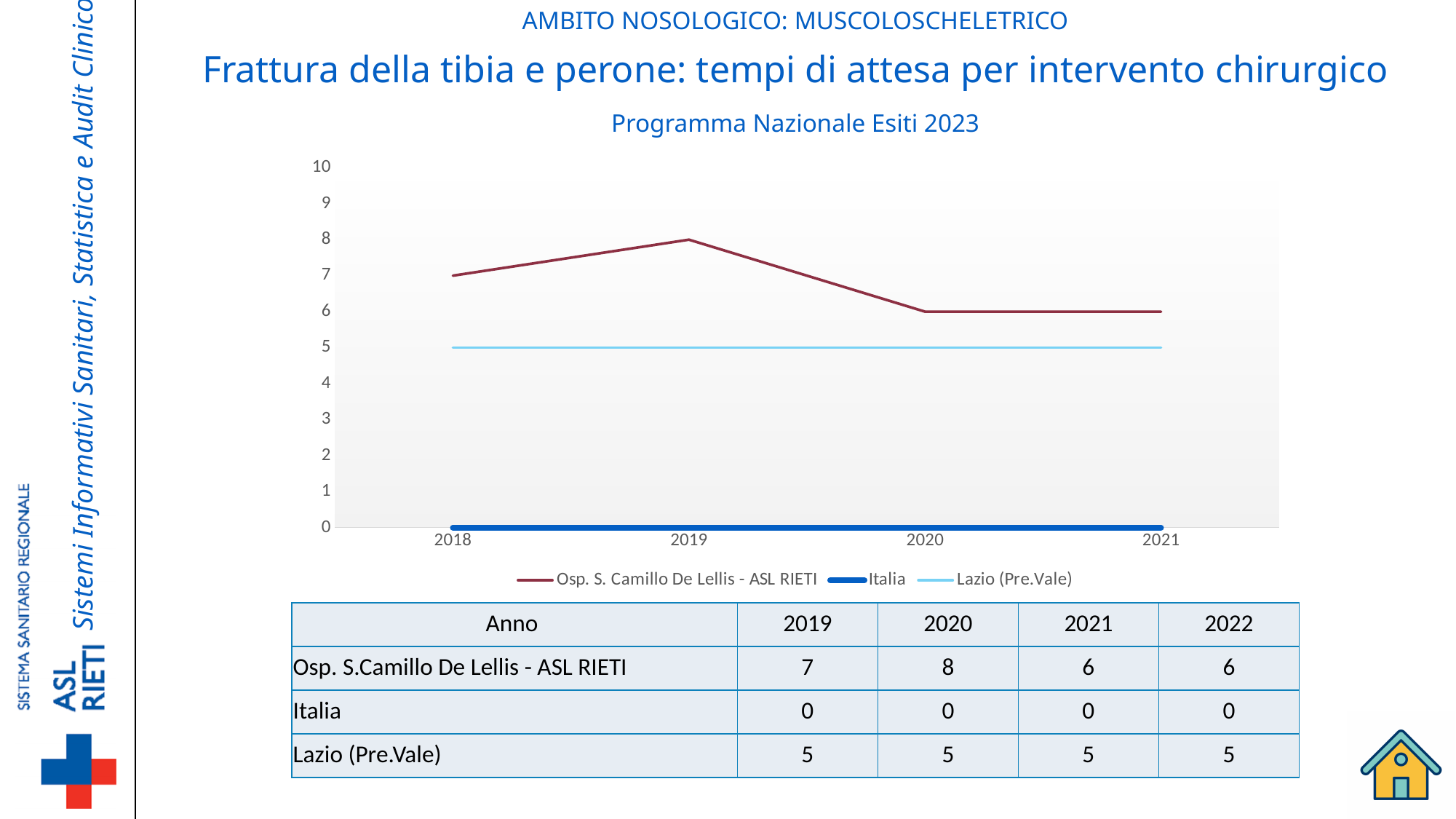
How many years are shown on the x axis of the chart? 4 Which series has the lowest values on the chart? Italia How many series does the chart legend list? 3 What is the value for Osp. S. Camillo De Lellis - ASL RIETI at 2018 on the chart? 7 What is the difference between the Osp. S. Camillo De Lellis - ASL RIETI value at 2019 and at 2021 on the chart? 2 Does the Osp. S. Camillo De Lellis - ASL RIETI line rise or fall from 2019 to 2020? fall What is the value for Osp. S. Camillo De Lellis - ASL RIETI at 2019 on the chart? 8 Which is larger at 2020: the value for Osp. S. Camillo De Lellis - ASL RIETI or for Lazio (Pre.Vale)? Osp. S. Camillo De Lellis - ASL RIETI What is the value for Italia at 2021 on the chart? 0 What kind of chart is shown on the slide? line chart In which year does the Osp. S. Camillo De Lellis - ASL RIETI line reach its highest value? 2019 What is the value for Lazio (Pre.Vale) at 2020 on the chart? 5